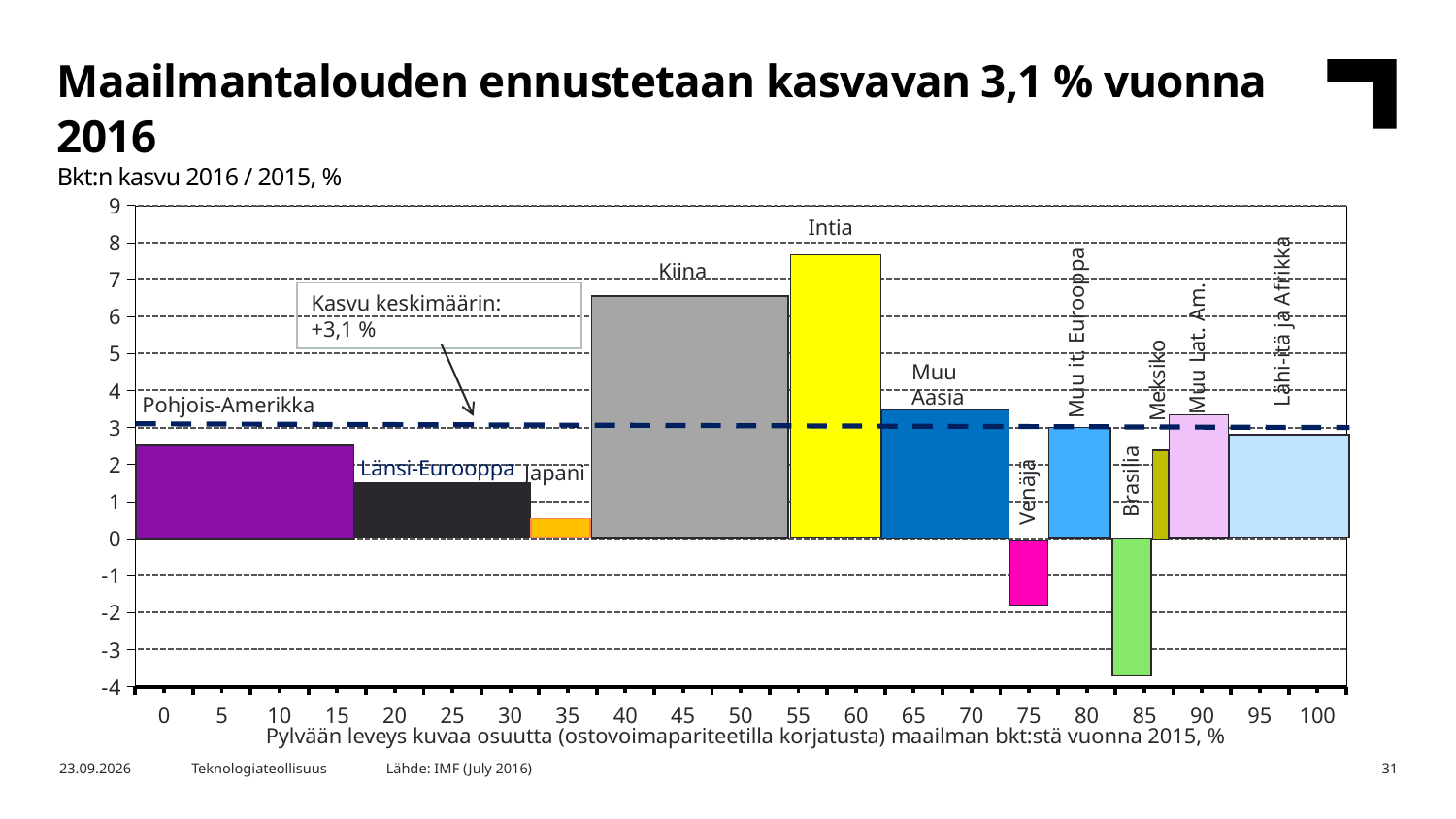
Which has the higher GDP growth, Pohjois-Amerikka or Länsi-Eurooppa? Pohjois-Amerikka Is the value for Brasilia greater or less than -3? less Is the value for Japani greater or less than 1? less How many regions are shown as bars in the chart? 12 Which region has the highest GDP growth in the chart? Intia Is the value for Venäjä greater or less than -1? less Which has the higher GDP growth, Kiina or Intia? Intia Which region has the lowest GDP growth in the chart? Brasilia What is the title of the slide? Maailmantalouden ennustetaan kasvavan 3,1 % vuonna 2016 What type of chart is shown on the slide? Bar chart What is the average growth (Kasvu keskimäärin) shown on the chart? +3,1 %